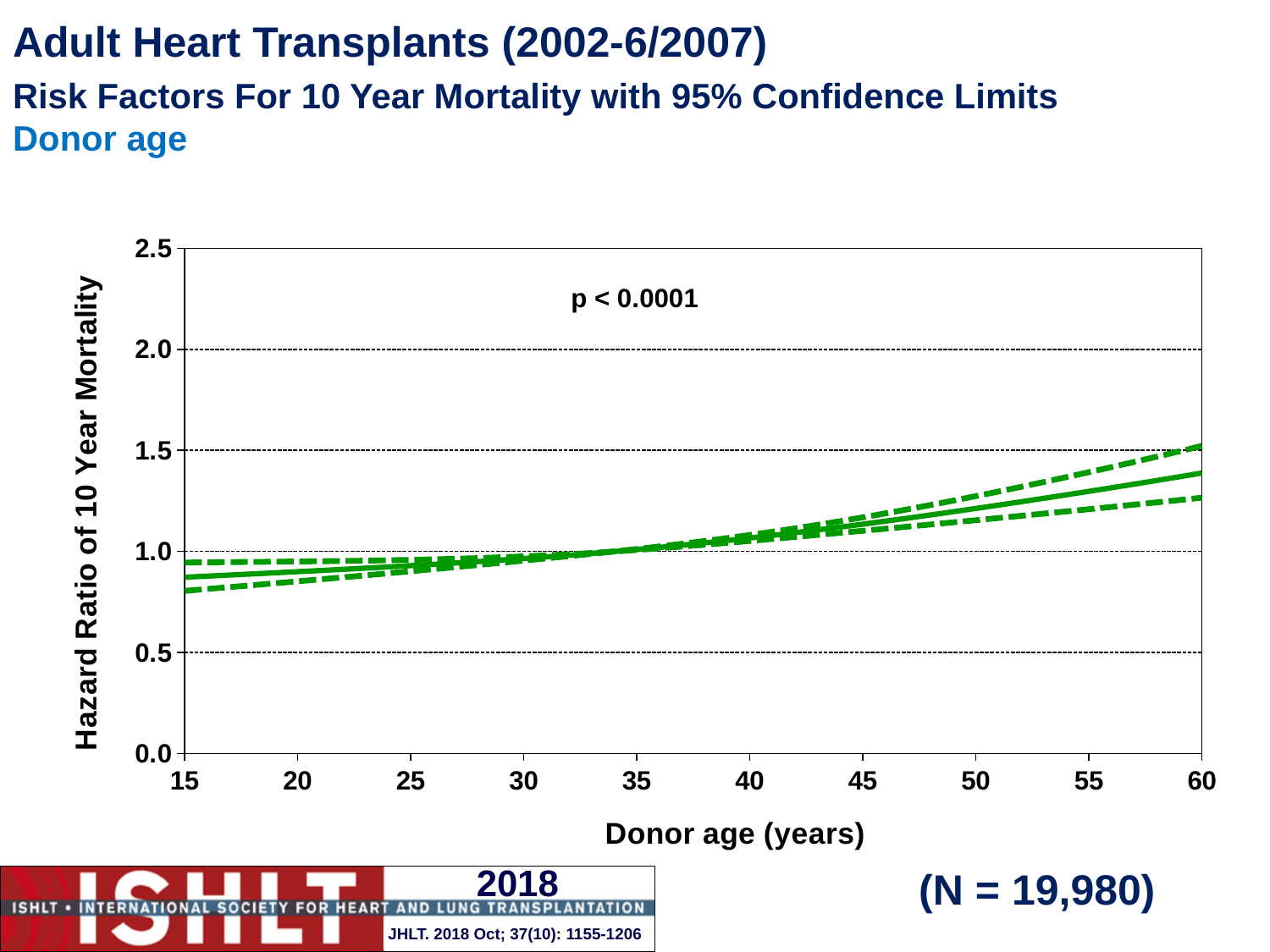
What p-value is printed on the chart? p < 0.0001 Which has the larger hazard ratio on the solid line: a donor age of 15 years or a donor age of 60 years? 60 years What kind of chart is shown on the slide? line chart What is the highest value shown on the y axis of the chart? 2.5 Is the hazard ratio on the solid line at a donor age of 60 years greater or less than 1.5? less Is the hazard ratio on the solid line at a donor age of 15 years greater or less than 1.0? less How many lines are plotted on the chart (including the confidence limit lines)? 3 Does the hazard ratio of 10 year mortality rise or fall as donor age increases from 15 to 60 years? rise Is the hazard ratio on the solid line at a donor age of 45 years greater or less than 1.0? greater